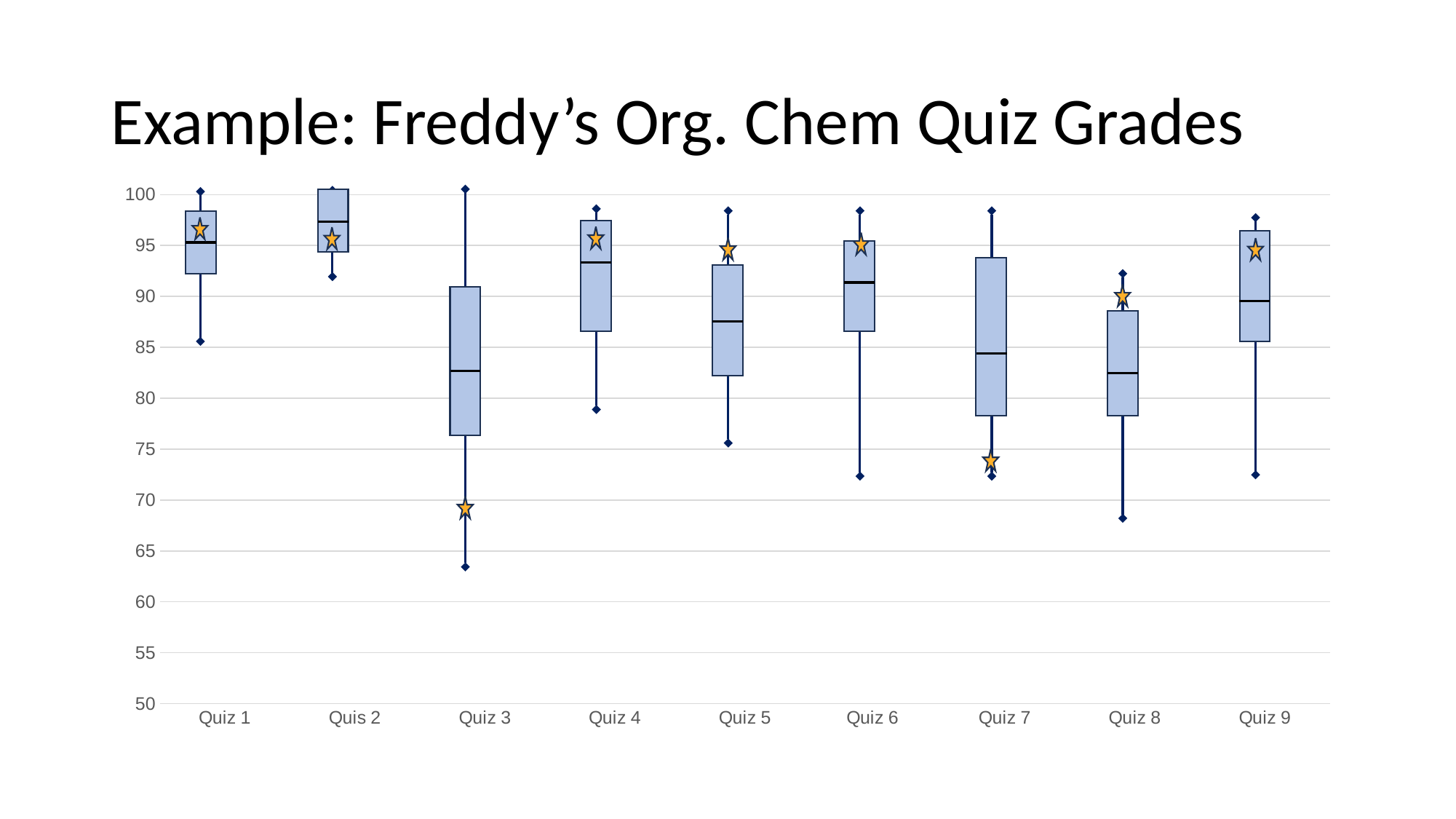
Is the lower whisker (minimum) for Quiz 8 greater or less than 70? less Which has the higher median, Quiz 4 or Quiz 5? Quiz 4 Is the upper whisker (maximum) for Quiz 8 greater or less than 95? less What is the title of the slide containing the chart? Example: Freddy’s Org. Chem Quiz Grades Is the star marker for Quiz 3 greater or less than 75? less How many quizzes are plotted along the x axis? 9 Which quiz has the lowest minimum whisker value? Quiz 3 Which quiz has the highest median line? Quis 2 What kind of chart is shown on the slide? Box-and-whisker plot